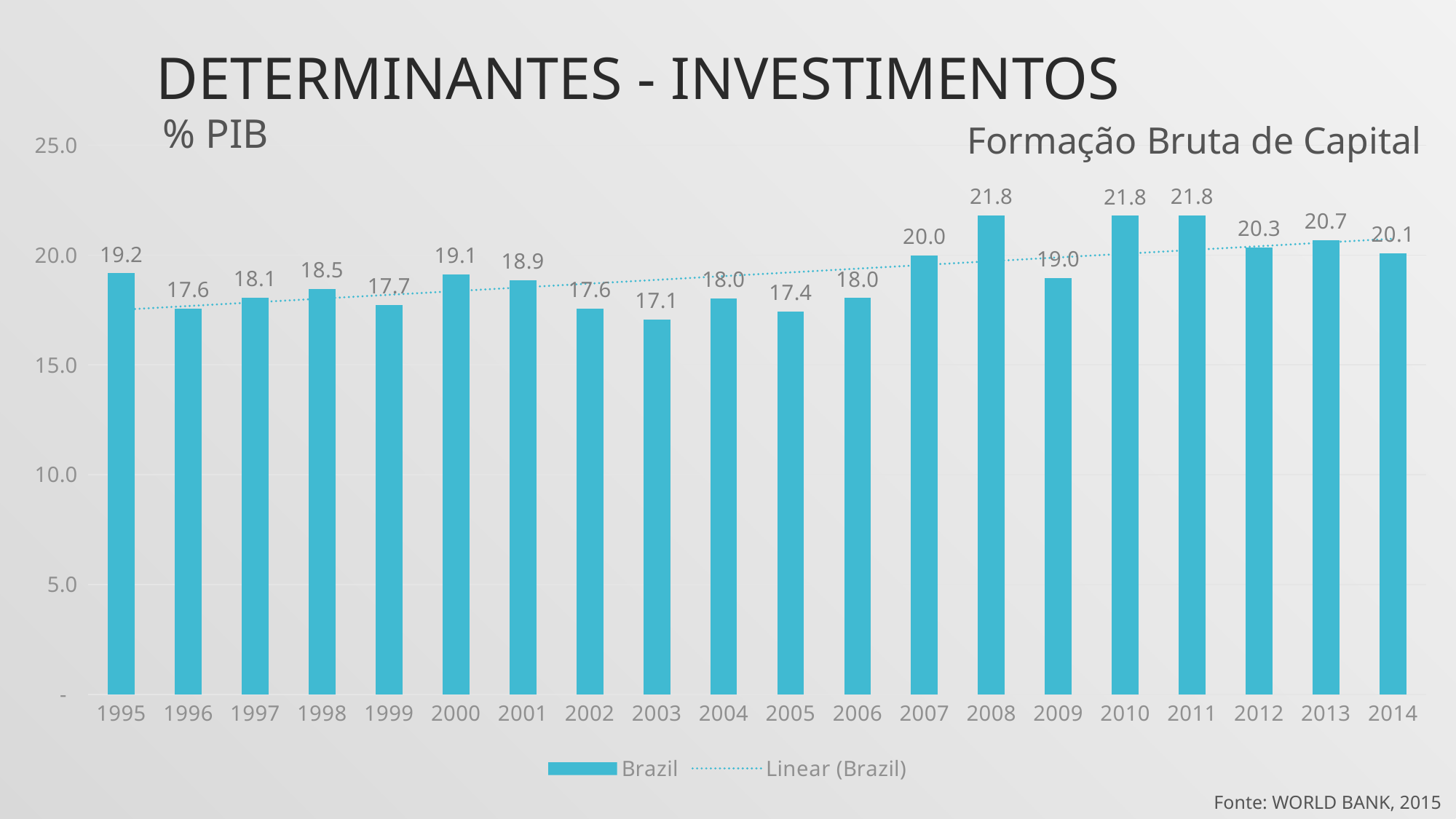
Is the value for 2007 greater or less than 15.0? greater How many entries does the legend list? 2 What is the difference between the values for 2008 and 2009? 2.8 Which is larger, the value for 1995 or the value for 1996? 1995 How many years are shown on the x axis? 20 What is the title shown at the top right of the chart? Formação Bruta de Capital Which year has the lowest value? 2003 What is the difference between the values for 2013 and 2012? 0.4 What is the value for Brazil in 2014? 20.1 What kind of chart is this? bar chart What is the value for Brazil in 2008? 21.8 What is the value for Brazil in 2003? 17.1